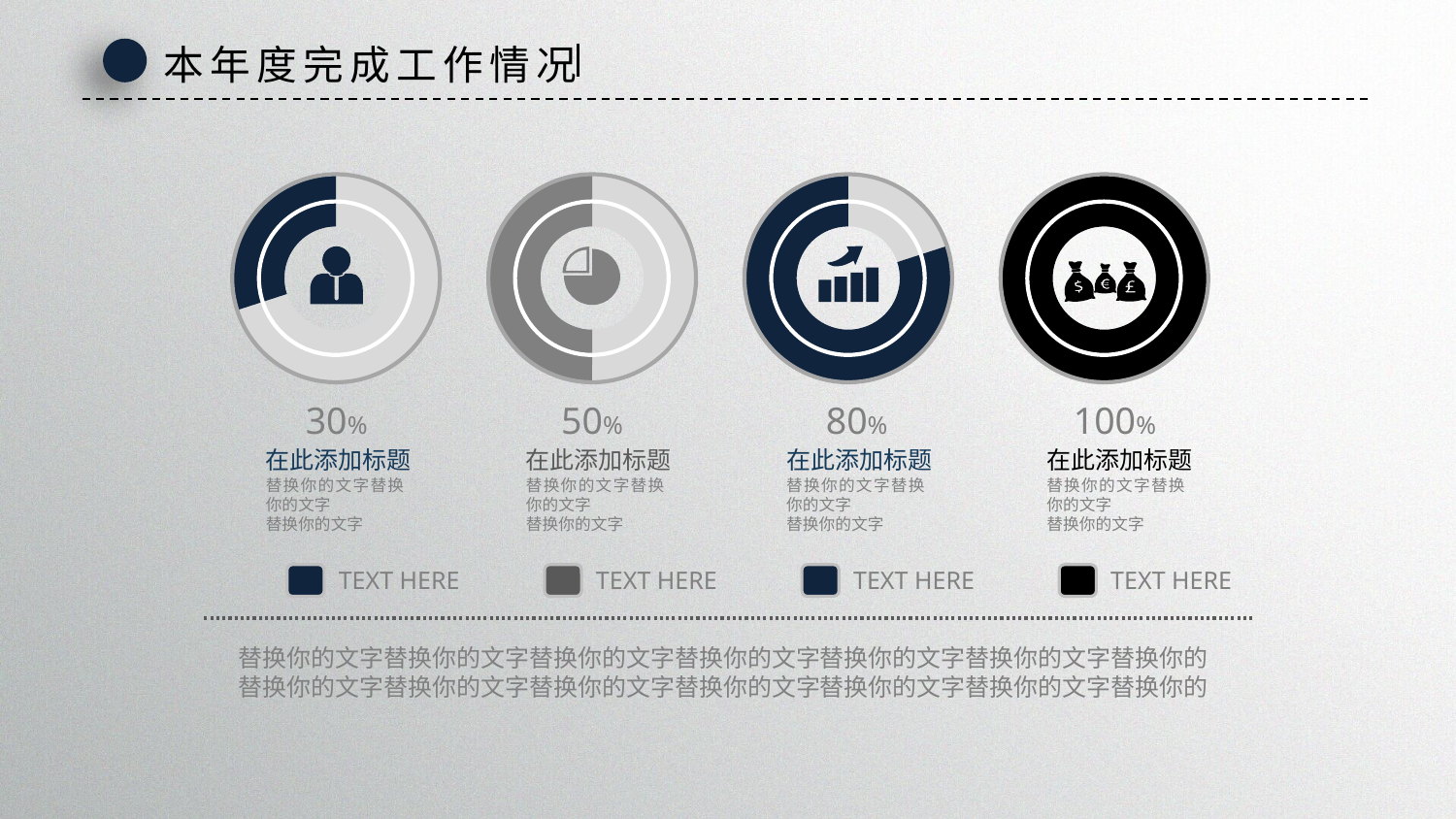
What percentage is shown below the third ring chart, the one with the bar-chart-and-arrow icon? 80% What is the difference between the percentage of the third ring chart and the percentage of the first ring chart? 50% What percentage is shown below the fourth (rightmost) ring chart, the one with the money-bag icons? 100% Do the percentages rise or fall from the leftmost ring chart to the rightmost ring chart? Rise Which of the four ring charts shows the lowest percentage? The first (leftmost) one, 30% How many ring charts are shown on the slide? 4 What percentage is shown below the first (leftmost) ring chart, the one with the person icon? 30% Which of the four ring charts shows the highest percentage? The fourth (rightmost) one, 100% What kind of chart is used to display each percentage on the slide? Ring (donut) chart Which is larger: the percentage of the second ring chart or the percentage of the third ring chart? The third ring chart (80%) What is the title of the slide containing the four ring charts? 本年度完成工作情况 What percentage is shown below the second ring chart, the one with the pie icon? 50%